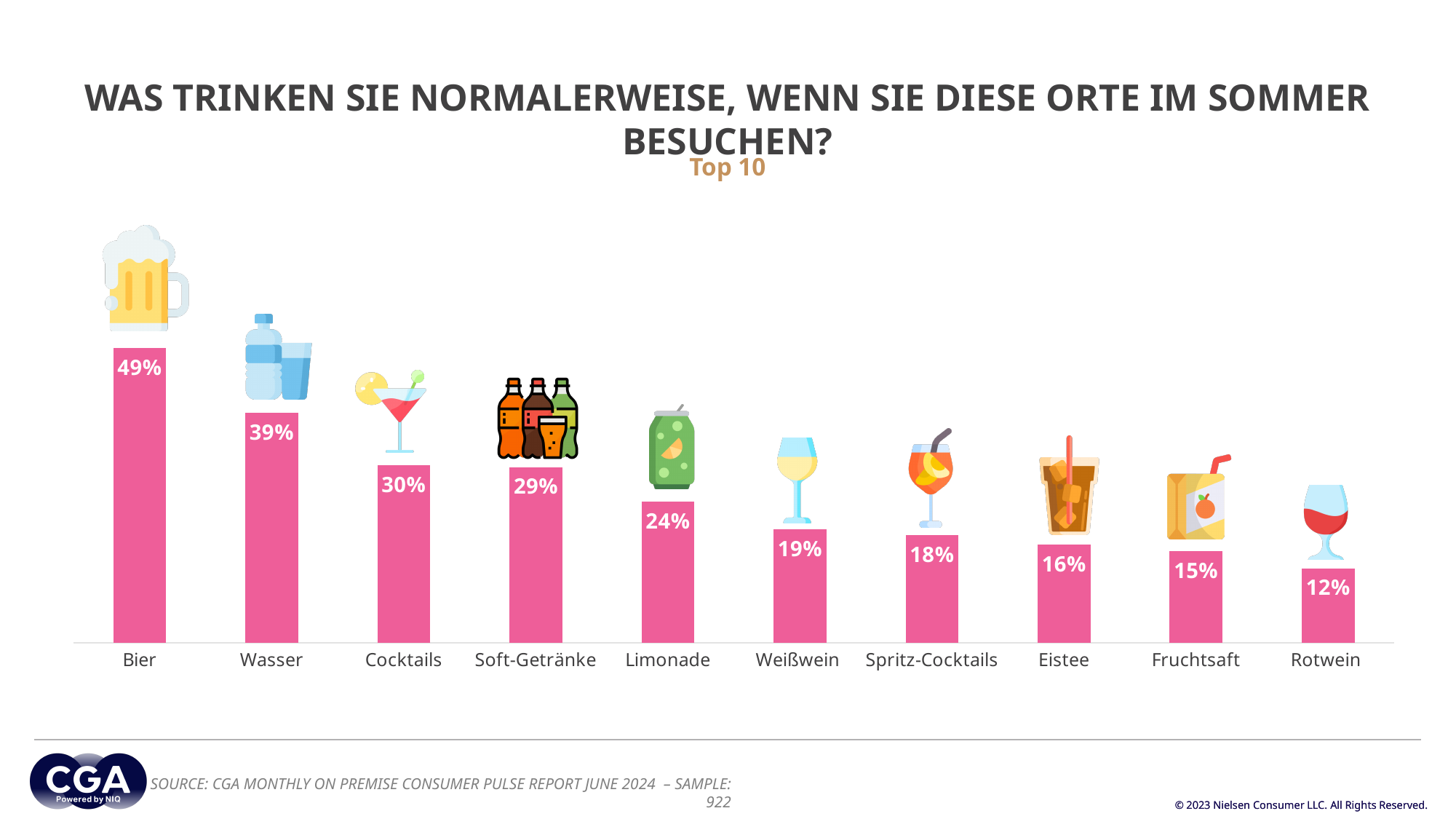
What is the subtitle shown below the chart title? Top 10 How many categories are shown in the chart? 10 What is the difference between the values for Wasser and Cocktails? 9% Which category has the lowest value? Rotwein What is the value for Bier? 49% What kind of chart is shown on the slide? Bar chart What is the difference between the values for Bier and Rotwein? 37% What is the value for Fruchtsaft? 15% Which category has the highest value? Bier Do the values rise or fall from left to right along the x axis? Fall Which is larger, the value for Weißwein or the value for Eistee? Weißwein What is the value for Limonade? 24%